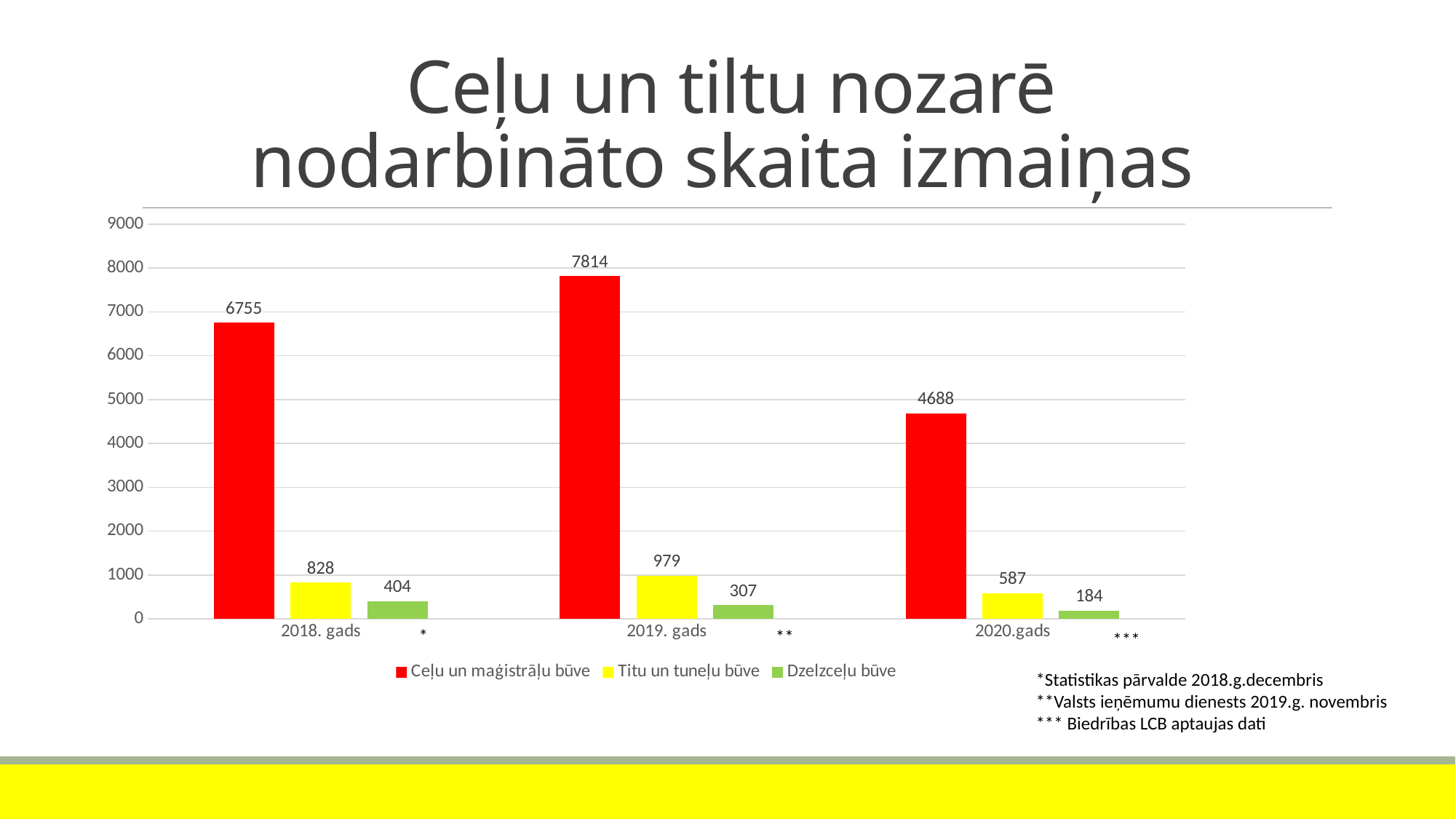
Which is larger: Tiltu un tuneļu būve in 2019. gads or Tiltu un tuneļu būve in 2020.gads? 2019. gads How many year categories are shown on the x axis? 3 What is the value for Tiltu un tuneļu būve in 2018. gads? 828 What is the difference between the Ceļu un maģistrāļu būve values for 2019. gads and 2020.gads? 3126 In which year is the value for Ceļu un maģistrāļu būve highest? 2019. gads How many series does the legend list? 3 What kind of chart is shown on the slide? bar chart What is the value for Ceļu un maģistrāļu būve in 2019. gads? 7814 What is the value for Dzelzceļu būve in 2020.gads? 184 Is the value for Ceļu un maģistrāļu būve in 2020.gads greater or less than 5000? less Which colour represents Dzelzceļu būve in the chart? green In which year is the value for Dzelzceļu būve lowest? 2020.gads